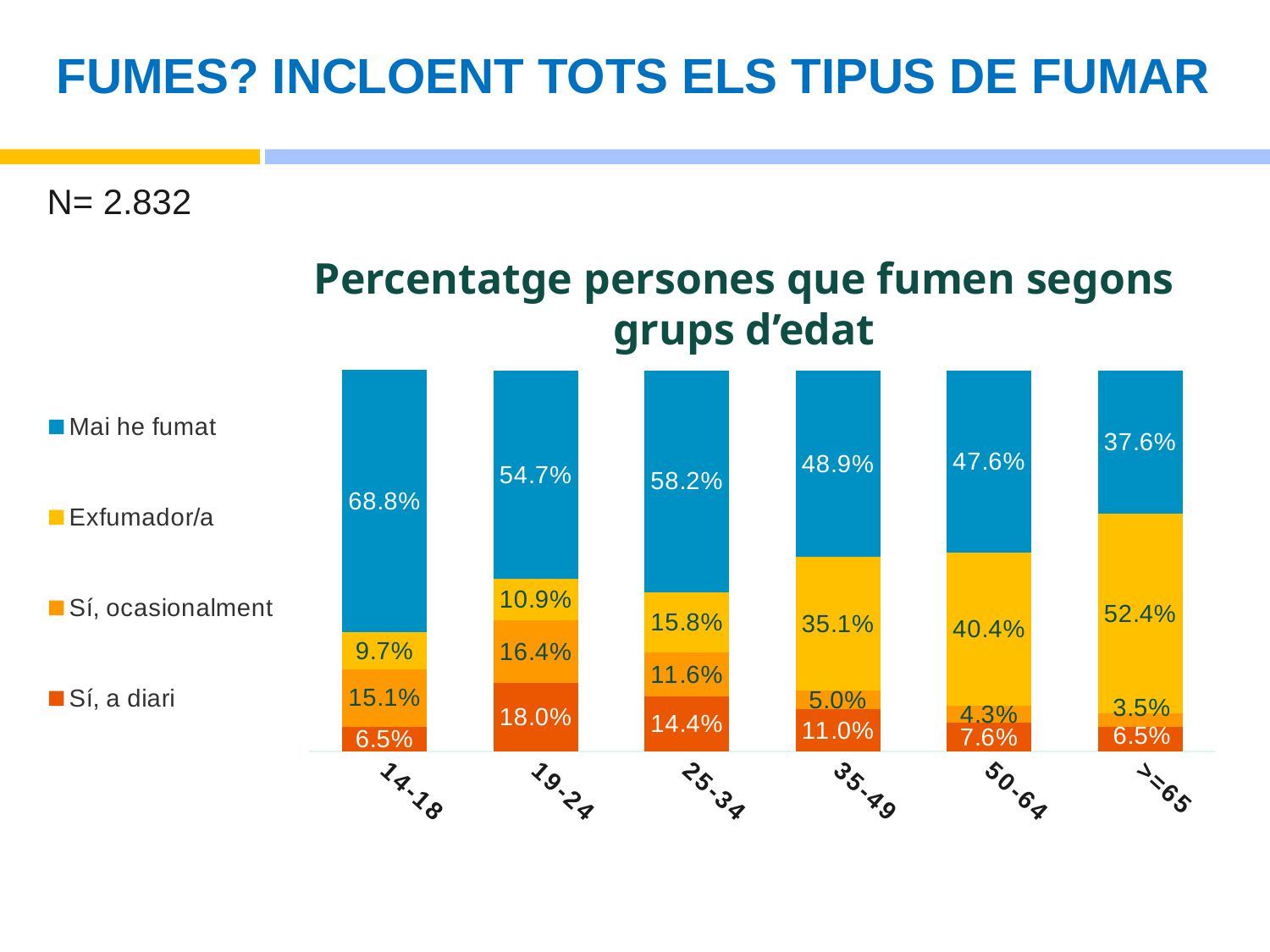
What is the difference between the "Exfumador/a" values for the 50-64 and 35-49 age groups? 5.3% Does the "Exfumador/a" percentage generally rise or fall from the 14-18 group to the >=65 group? Rise Which age group has the lowest "Sí, ocasionalment" percentage? >=65 Which is larger: the "Sí, a diari" value for 25-34 or for 35-49? 25-34 What percentage of the 14-18 age group answered "Mai he fumat"? 68.8% What is the "Sí, a diari" value for the 19-24 age group? 18.0% What is the "Sí, ocasionalment" value for the 35-49 age group? 5.0% Which age group has the highest "Mai he fumat" percentage? 14-18 How many age groups are shown on the x axis? 6 How many series does the legend list? 4 What is the "Exfumador/a" value for the >=65 age group? 52.4% What kind of chart is shown on the slide? Stacked bar chart